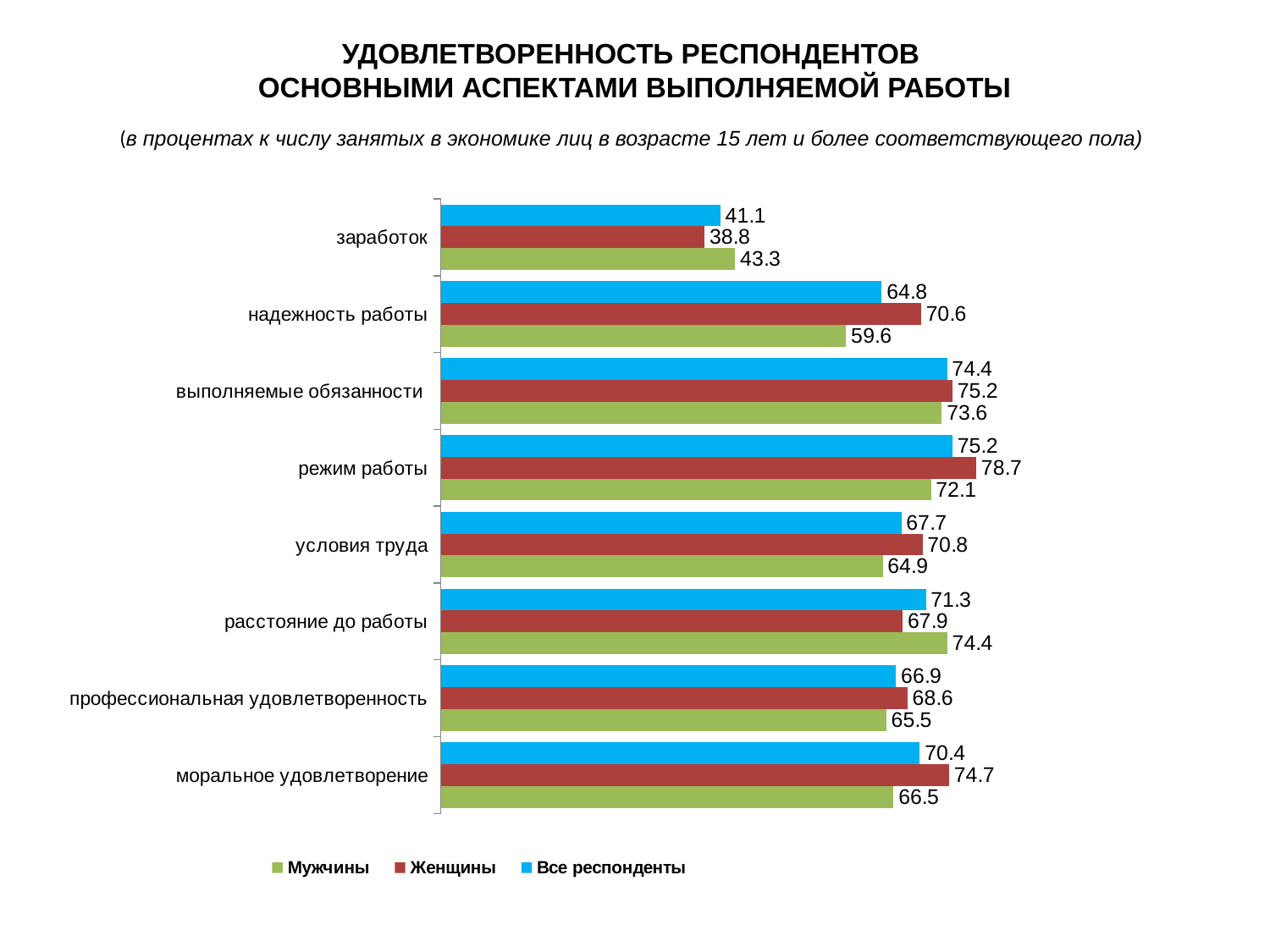
Which colour represents the series Все респонденты in the legend? blue What is the value for Мужчины in the category заработок? 43.3 What is the difference between the Женщины and Мужчины values for моральное удовлетворение? 8.2 What is the difference between the Женщины and Мужчины values for надежность работы? 11.0 What is the value for Женщины in the category режим работы? 78.7 Which category has the lowest value for Все респонденты? заработок What type of chart is shown on the slide? bar chart How many categories (aspects of work) are shown on the chart? 8 What is the value for Все респонденты in the category условия труда? 67.7 Which is larger for расстояние до работы: the value for Мужчины or the value for Женщины? Мужчины Which category has the highest value for Женщины? режим работы How many series does the legend list? 3